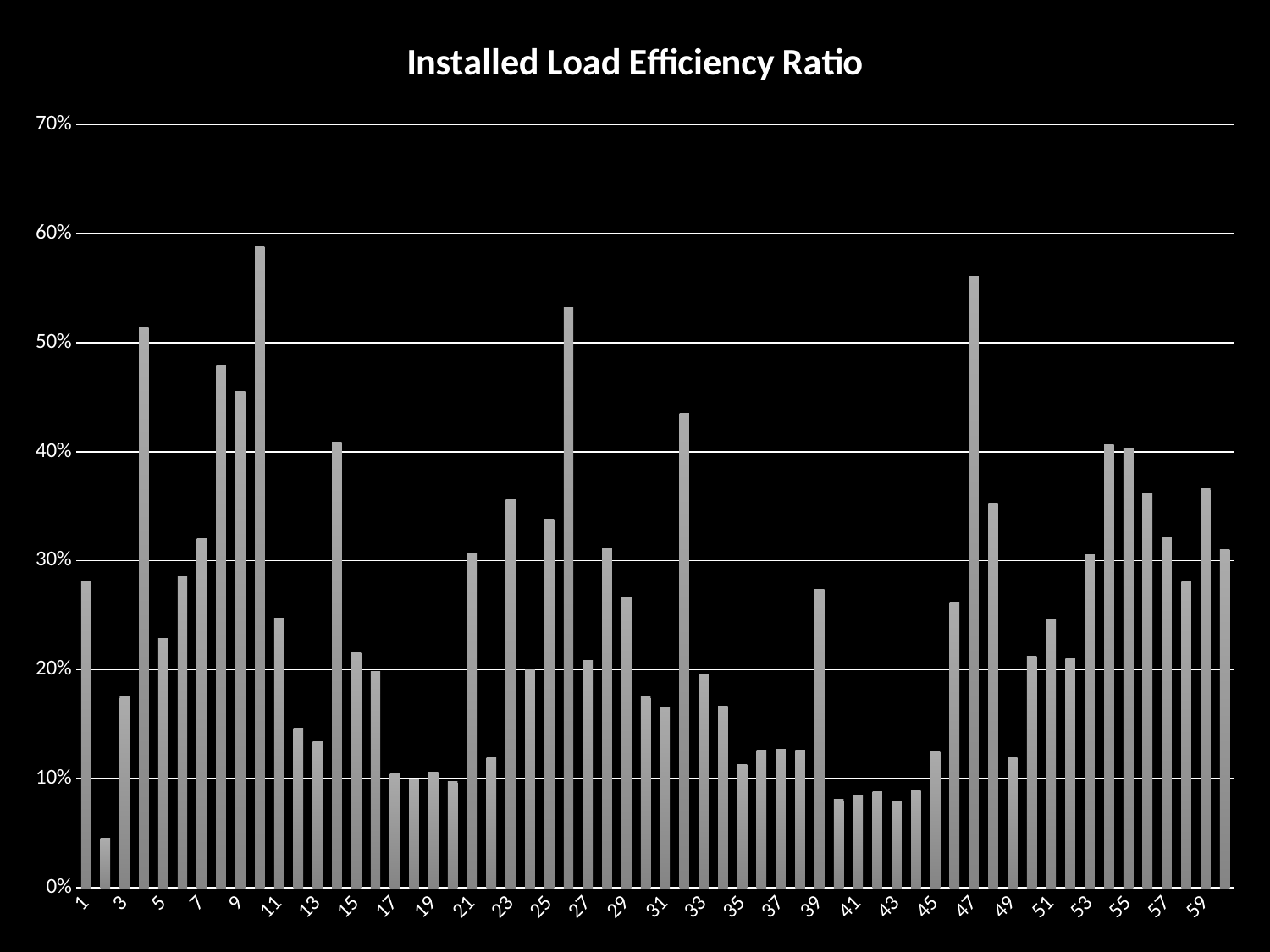
Is the value for category 10 greater or less than 50%? greater Is the value for category 1 greater or less than 30%? less Which category has the highest Installed Load Efficiency Ratio? 10 Is the value for category 47 greater or less than 50%? greater What kind of chart is shown on the slide? bar chart Which has the larger value, category 4 or category 47? 47 Which category has the lowest Installed Load Efficiency Ratio? 2 Which has the larger value, category 14 or category 15? 14 What is the title of the chart? Installed Load Efficiency Ratio How many bars (categories) are plotted in the chart? 60